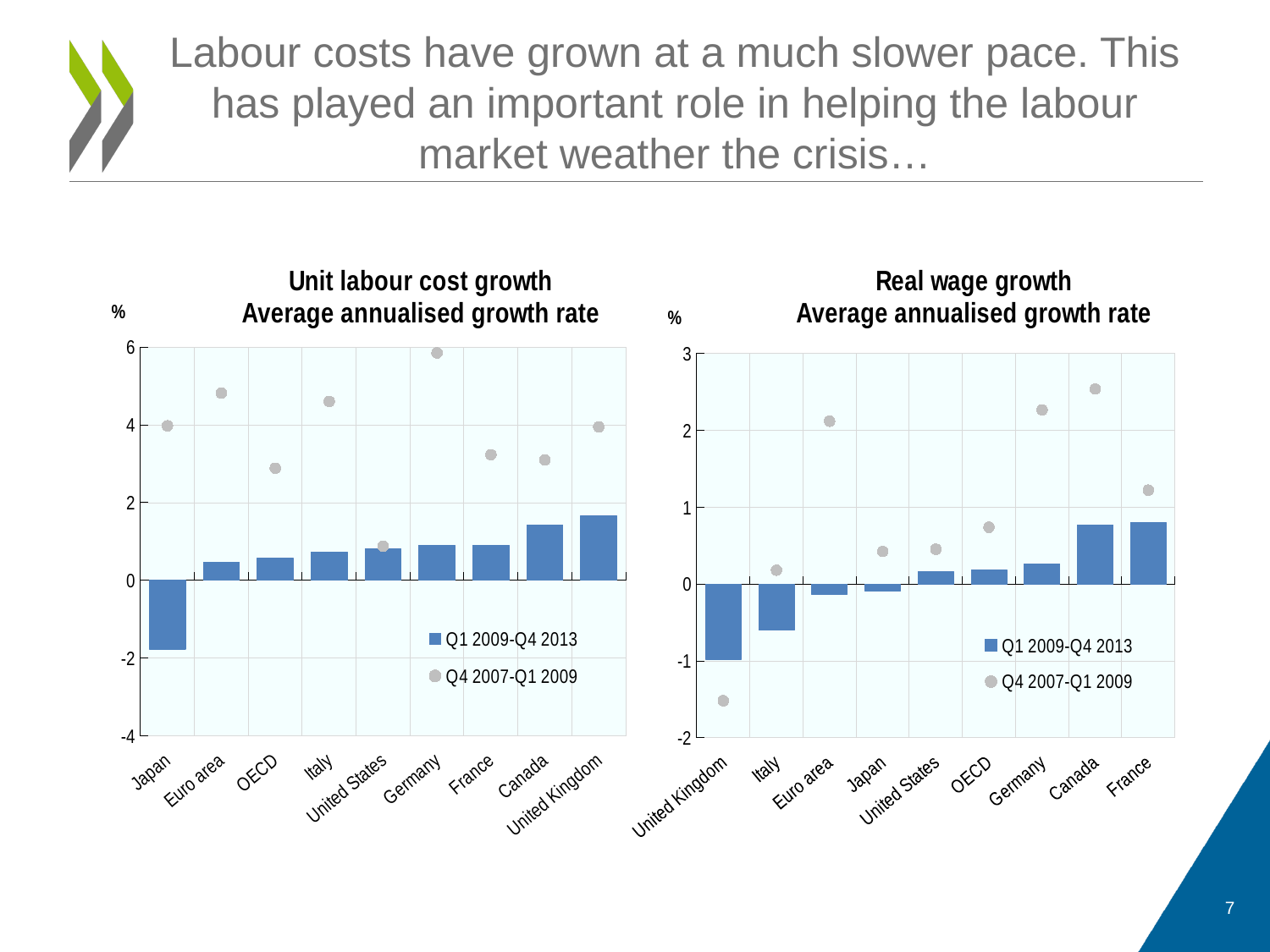
How many series does the legend of the Unit labour cost growth chart list? 2 In the Real wage growth chart, do the Q1 2009-Q4 2013 bars generally rise or fall from left to right along the x axis? rise In the Unit labour cost growth chart, which category has the lowest bar for Q1 2009-Q4 2013? Japan In the Unit labour cost growth chart, is the Q4 2007-Q1 2009 value for Euro area greater or less than 4? greater How many categories are shown on the x axis of the Unit labour cost growth chart? 9 In the Real wage growth chart, is the Q4 2007-Q1 2009 value for United Kingdom greater or less than -1? less In the Real wage growth chart, which category has the highest Q4 2007-Q1 2009 marker? Canada In the Unit labour cost growth chart, is the Q1 2009-Q4 2013 value for Japan greater or less than 0? less In the Real wage growth chart, which category has the lowest bar for Q1 2009-Q4 2013? United Kingdom What are the two legend entries in the Real wage growth chart? Q1 2009-Q4 2013 and Q4 2007-Q1 2009 In the Unit labour cost growth chart, which is larger for Q1 2009-Q4 2013: United Kingdom or Euro area? United Kingdom In the Unit labour cost growth chart, which category has the highest Q4 2007-Q1 2009 marker? Germany